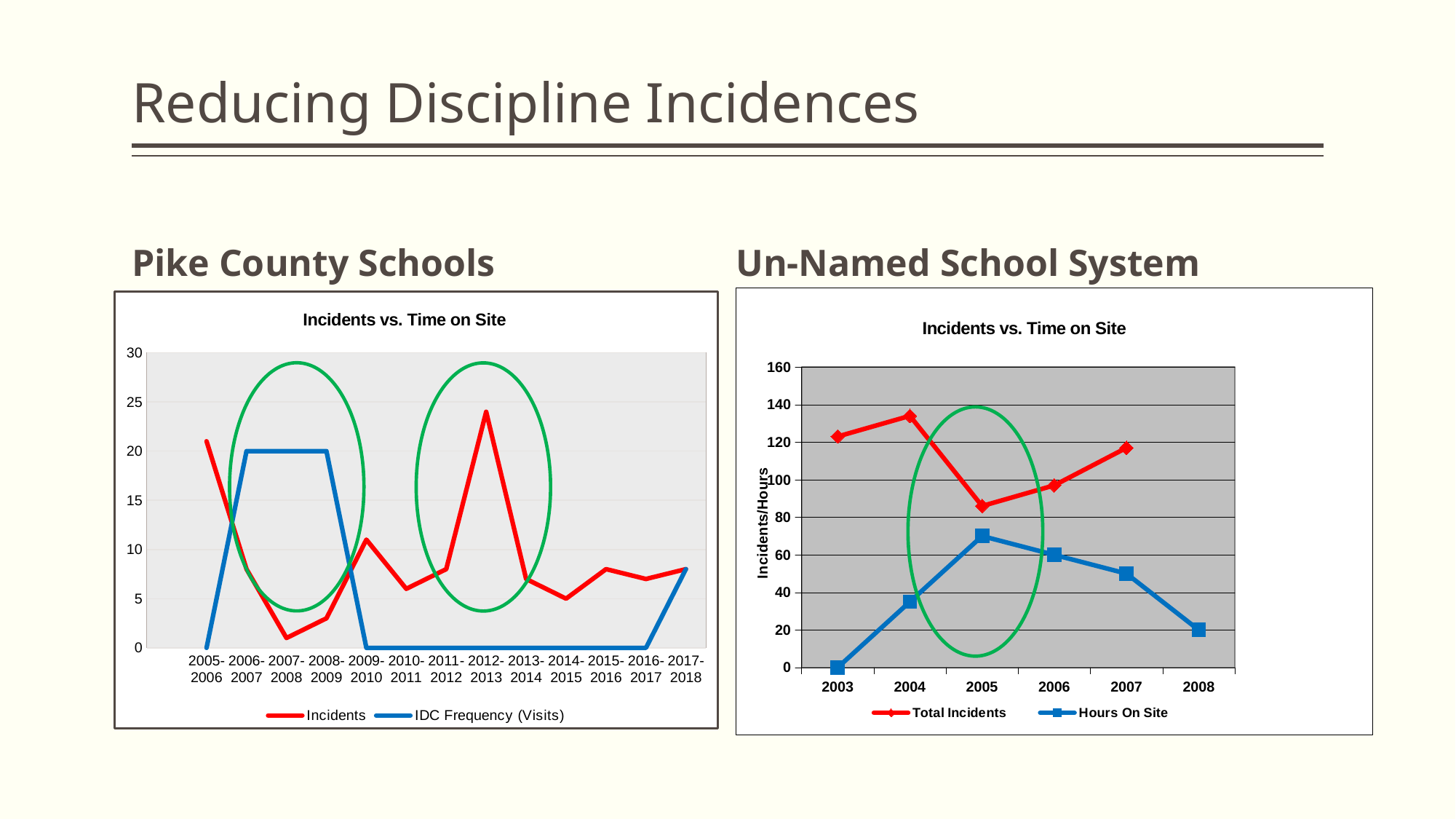
What kind of chart is the Pike County Schools chart? line chart In the Pike County Schools chart, in which school year is the Incidents value lowest? 2007-2008 How many years are shown on the x axis of the Un-Named School System chart? 6 In the Un-Named School System chart, what is the Hours On Site value for 2003? 0 In the Pike County Schools chart, in which school year is the Incidents value highest? 2012-2013 In the Un-Named School System chart, does the Hours On Site line rise or fall from 2005 to 2008? fall In the Pike County Schools chart, what is the IDC Frequency (Visits) value for 2007-2008? 20 How many school years are shown on the x axis of the Pike County Schools chart? 13 In the Un-Named School System chart, which is larger in 2005: Total Incidents or Hours On Site? Total Incidents How many series does the legend of the Un-Named School System chart list? 2 In the Un-Named School System chart, which year has the highest Hours On Site value? 2005 In the Un-Named School System chart, is the Total Incidents value for 2004 greater or less than 120? greater